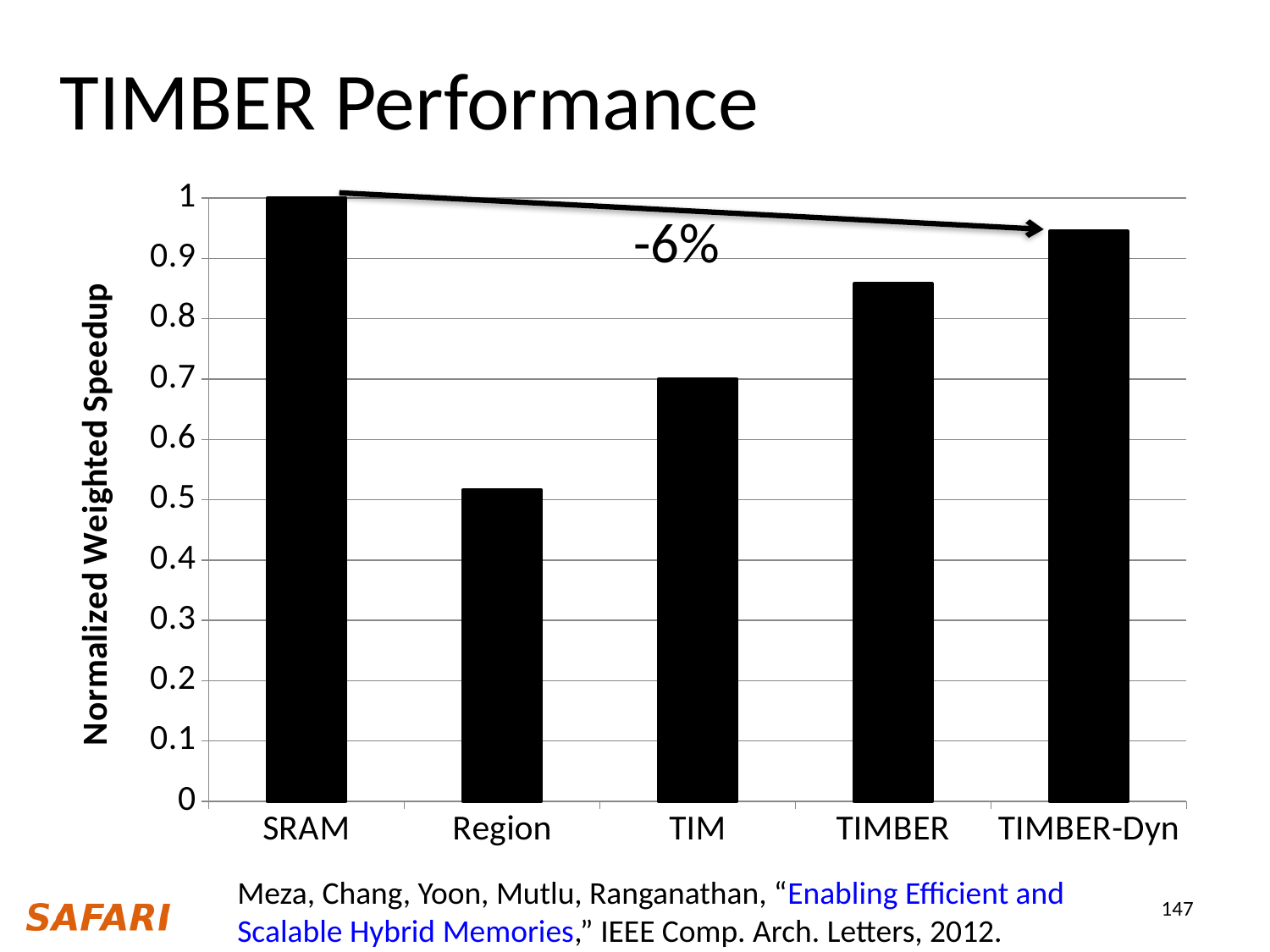
Which has a higher normalized weighted speedup, TIM or TIMBER? TIMBER Which category has the lowest normalized weighted speedup? Region What is the normalized weighted speedup for SRAM? 1 Which category has the highest normalized weighted speedup? SRAM Is the value for TIMBER greater or less than 0.8? greater What kind of chart is shown on the slide? bar chart What is the label on the y axis? Normalized Weighted Speedup What percentage is written next to the arrow from SRAM to TIMBER-Dyn? -6% Is the value for Region greater or less than 0.6? less How many categories are plotted on the x axis? 5 Is the value for TIMBER-Dyn greater or less than 0.9? greater Which has a higher normalized weighted speedup, Region or TIM? TIM